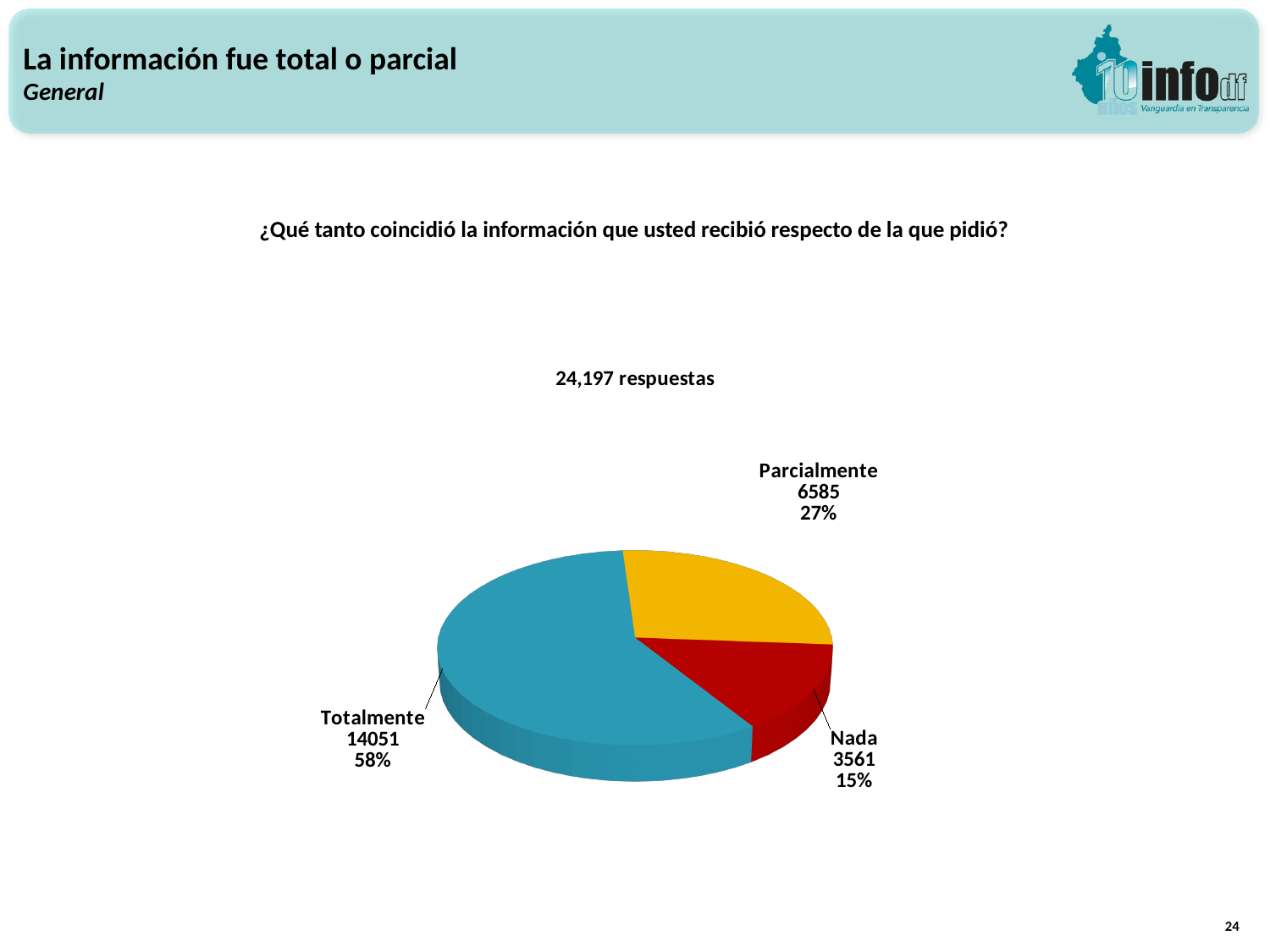
What share of the pie does Totalmente represent? 58% Which is larger, the value for Parcialmente or the value for Nada? Parcialmente What kind of chart is shown on the slide? Pie chart What is the value for Parcialmente? 6585 How many responses does the chart report in total? 24,197 respuestas What is the difference between the values for Totalmente and Parcialmente? 7466 Which category has the largest slice? Totalmente Which category has the smallest slice? Nada What is the value for Totalmente? 14051 What share of the pie does Nada represent? 15% What is the value for Nada? 3561 How many slices does the pie chart have? 3